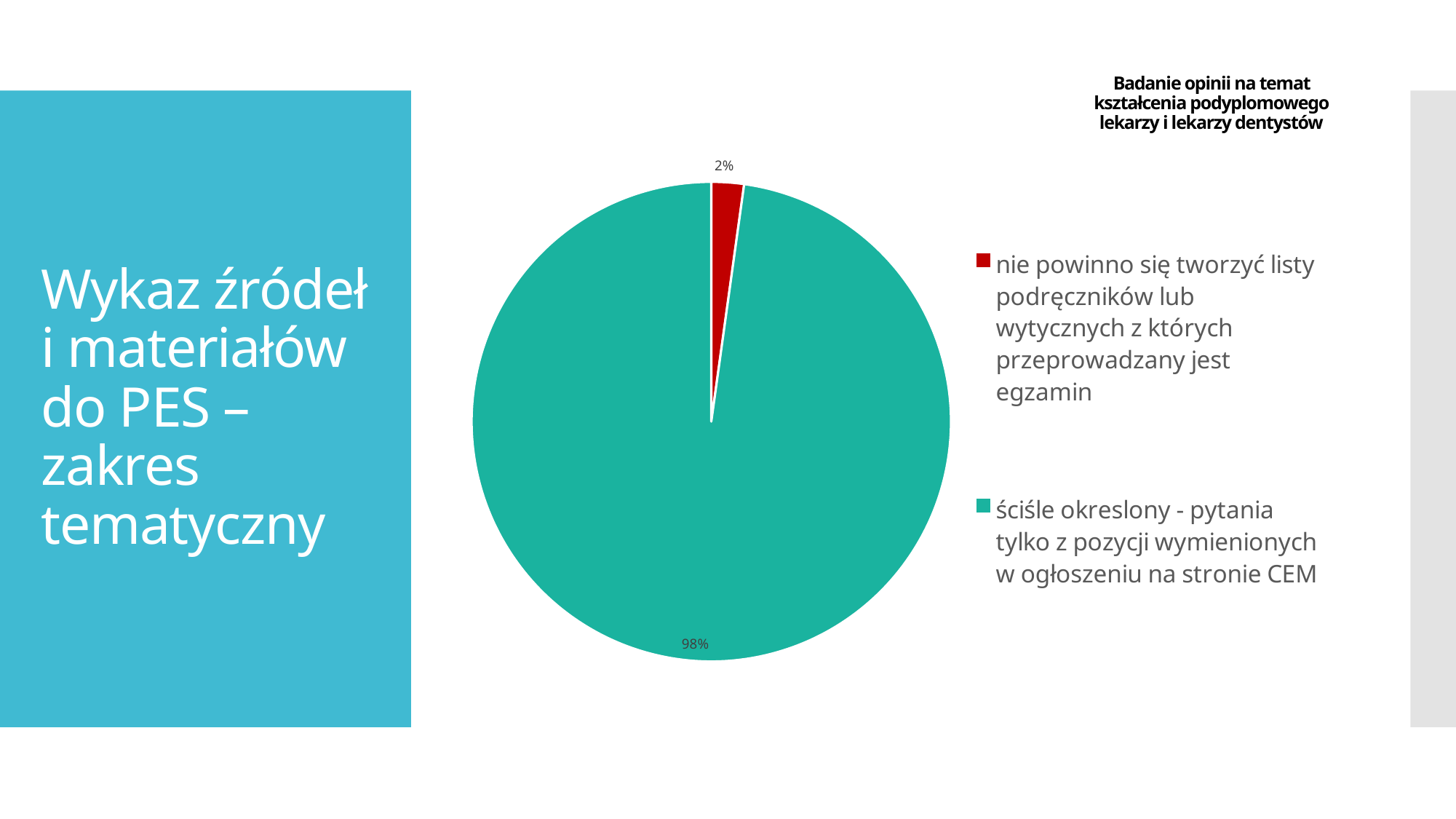
What share of the pie is labelled "ściśle okreslony - pytania tylko z pozycji wymienionych w ogłoszeniu na stronie CEM"? 98% Which slice is larger: the red one or the green one? the green one What colour is the slice for "nie powinno się tworzyć listy podręczników lub wytycznych z których przeprowadzany jest egzamin"? red What share of the pie is labelled "nie powinno się tworzyć listy podręczników lub wytycznych z których przeprowadzany jest egzamin"? 2% How many slices does the pie chart have? 2 Which category has the smallest slice of the pie? nie powinno się tworzyć listy podręczników lub wytycznych z których przeprowadzany jest egzamin Is the share for "ściśle okreslony - pytania tylko z pozycji wymienionych w ogłoszeniu na stronie CEM" greater or less than 50%? greater Which category has the largest slice of the pie? ściśle okreslony - pytania tylko z pozycji wymienionych w ogłoszeniu na stronie CEM What kind of chart is shown on the slide? pie chart How many entries does the legend list? 2 What is the difference in percentage points between the two slices of the pie? 96